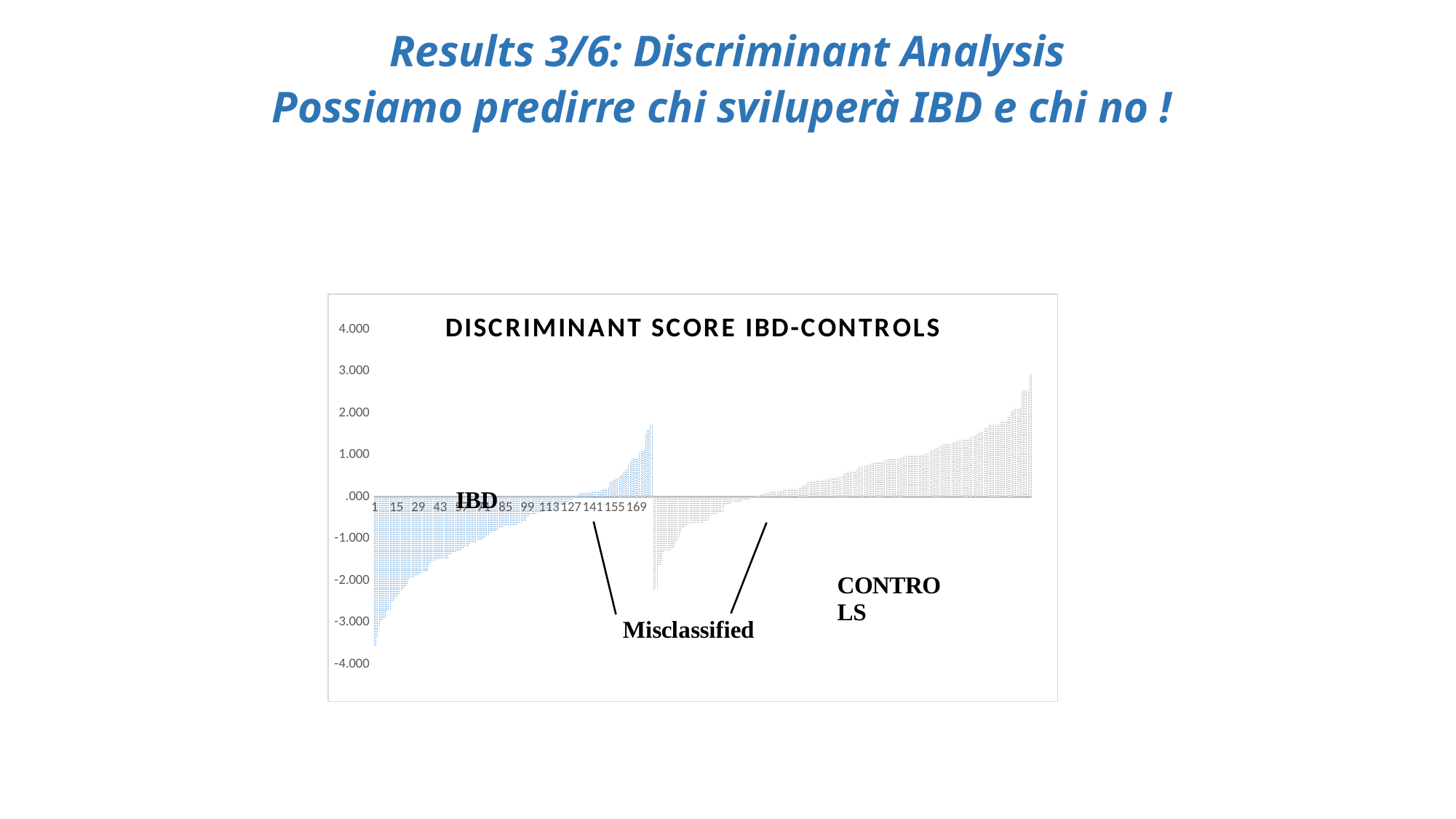
What kind of chart is shown on the slide? bar chart What is the highest value shown on the vertical axis of the chart? 4.000 Is the value for category 15 greater or less than -1.000? less Is the value for the first category (1) greater or less than -3.000? less Is the value for category 99 greater or less than -1.000? greater Which group's bars are shown in blue, IBD or CONTROLS? IBD Within the IBD group, do the bar values rise or fall from left to right along the x axis? rise Within the CONTROLS group, do the bar values rise or fall from left to right along the x axis? rise What is the title of the chart? DISCRIMINANT SCORE IBD-CONTROLS Which is larger: the value for category 1 or the value for category 169? 169